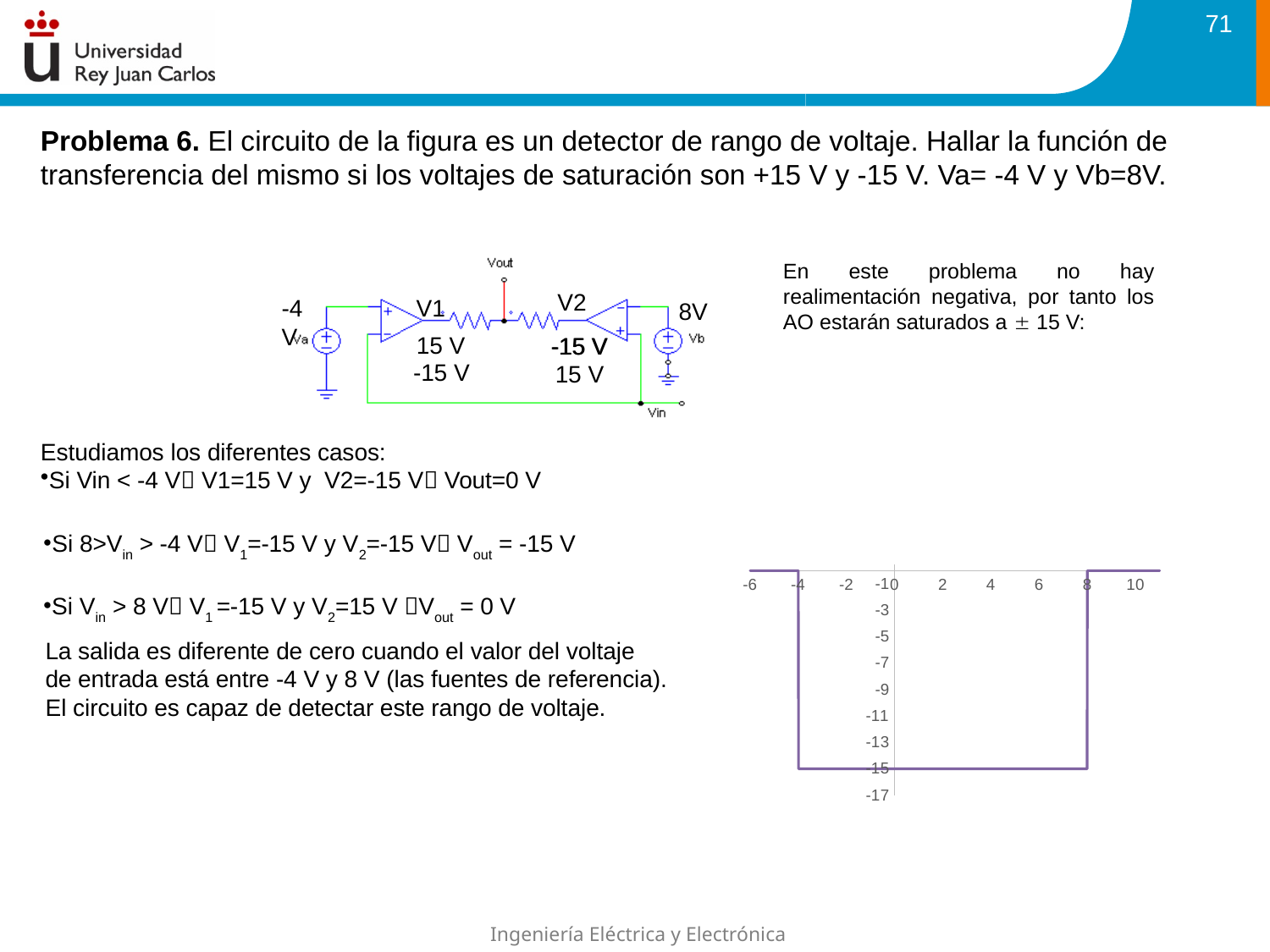
In the chart at the bottom right, what is the lowest value the plotted line reaches? -15 What kind of chart is shown at the bottom right of the slide? line chart In the chart at the bottom right, which is larger: the value of the line at x = -6 or at x = 6? x = -6 In the chart at the bottom right, what is the value of the plotted line at x = 2? -15 In the chart at the bottom right, at which x-axis value does the line drop from 0 down to -15? -4 In the chart at the bottom right, is the value of the line at x = 4 greater or less than -5? less In the chart at the bottom right, how many tick labels are shown on the x axis? 9 In the chart at the bottom right, does the line rise, fall or stay flat between x = 0 and x = 6? stay flat In the chart at the bottom right, what is the lowest tick label on the y axis? -17 In the chart at the bottom right, at which x-axis value does the line rise from -15 back up to 0? 8 In the chart at the bottom right, what is the value of the plotted line at x = 10? 0 In the chart at the bottom right, is the value of the line at x = -6 greater or less than -3? greater